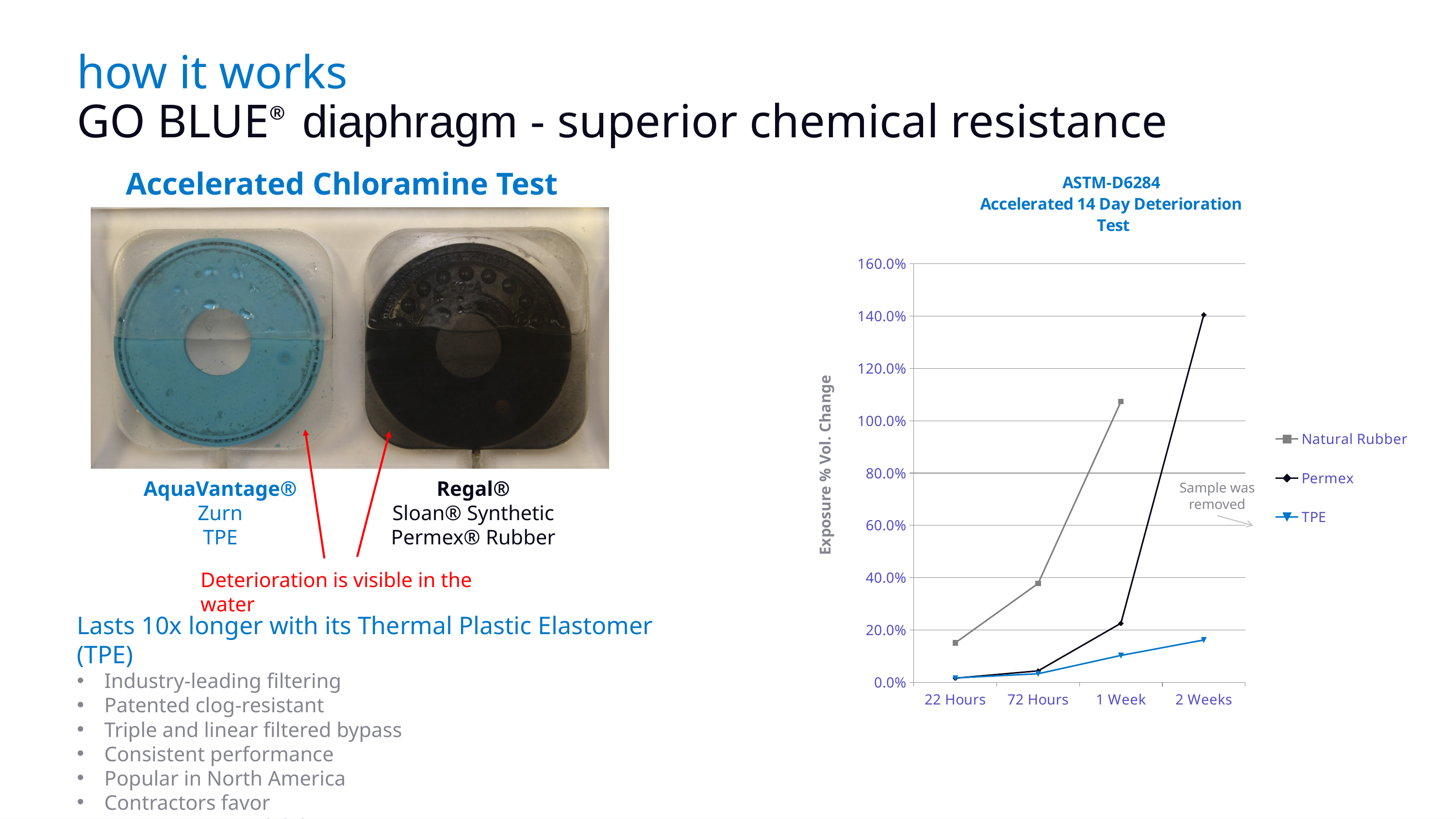
Does the TPE series rise or fall from 22 Hours to 2 Weeks? rise Which series has the lowest value at 1 Week? TPE Is the value for Permex at 2 Weeks greater or less than 120.0%? greater Which series has the highest value at 2 Weeks? Permex Is the value for Natural Rubber at 1 Week greater or less than 80.0%? greater What is the title of the chart's y axis? Exposure % Vol. Change How many series does the chart legend list? 3 Is the value for TPE at 2 Weeks greater or less than 20.0%? less At 2 Weeks, which is larger: Permex or TPE? Permex At 1 Week, which is larger: Natural Rubber or Permex? Natural Rubber What kind of chart is shown on the slide? line chart How many time points are shown on the x axis of the chart? 4